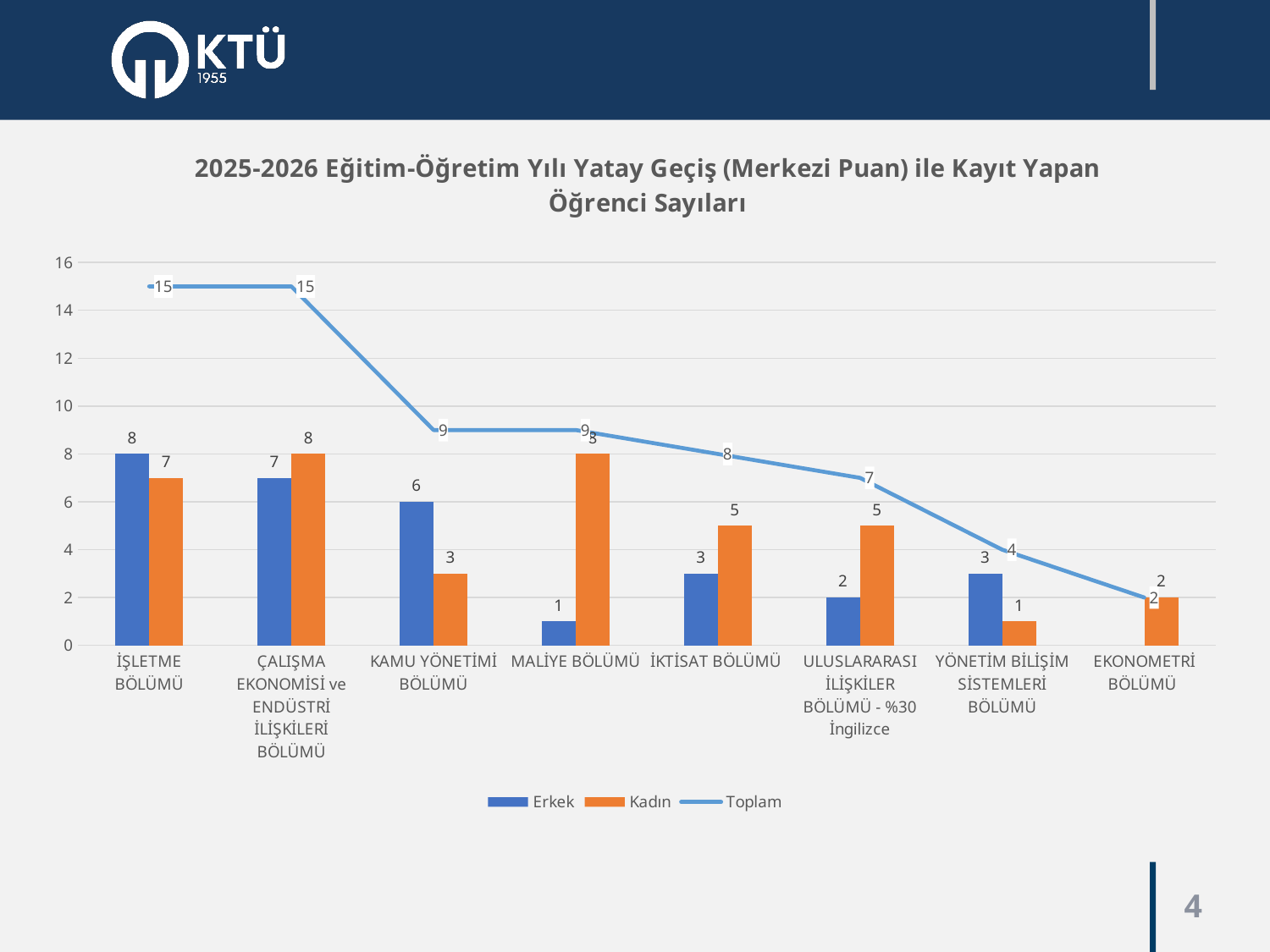
Which department has the lowest Toplam value? EKONOMETRİ BÖLÜMÜ What is the Erkek value for KAMU YÖNETİMİ BÖLÜMÜ? 6 Does the Toplam line rise or fall from left to right across the departments? fall What is the Kadın value for MALİYE BÖLÜMÜ? 8 How many departments are shown on the x axis? 8 Which series is drawn as a line rather than bars? Toplam What is the Toplam value for ULUSLARARASI İLİŞKİLER BÖLÜMÜ - %30 İngilizce? 7 Is the Toplam value for İKTİSAT BÖLÜMÜ greater or less than 10? less What is the difference between the Kadın and Erkek values for MALİYE BÖLÜMÜ? 7 Which department has the highest Erkek value? İŞLETME BÖLÜMÜ Which is larger for KAMU YÖNETİMİ BÖLÜMÜ, the Erkek value or the Kadın value? Erkek How many series does the legend list? 3